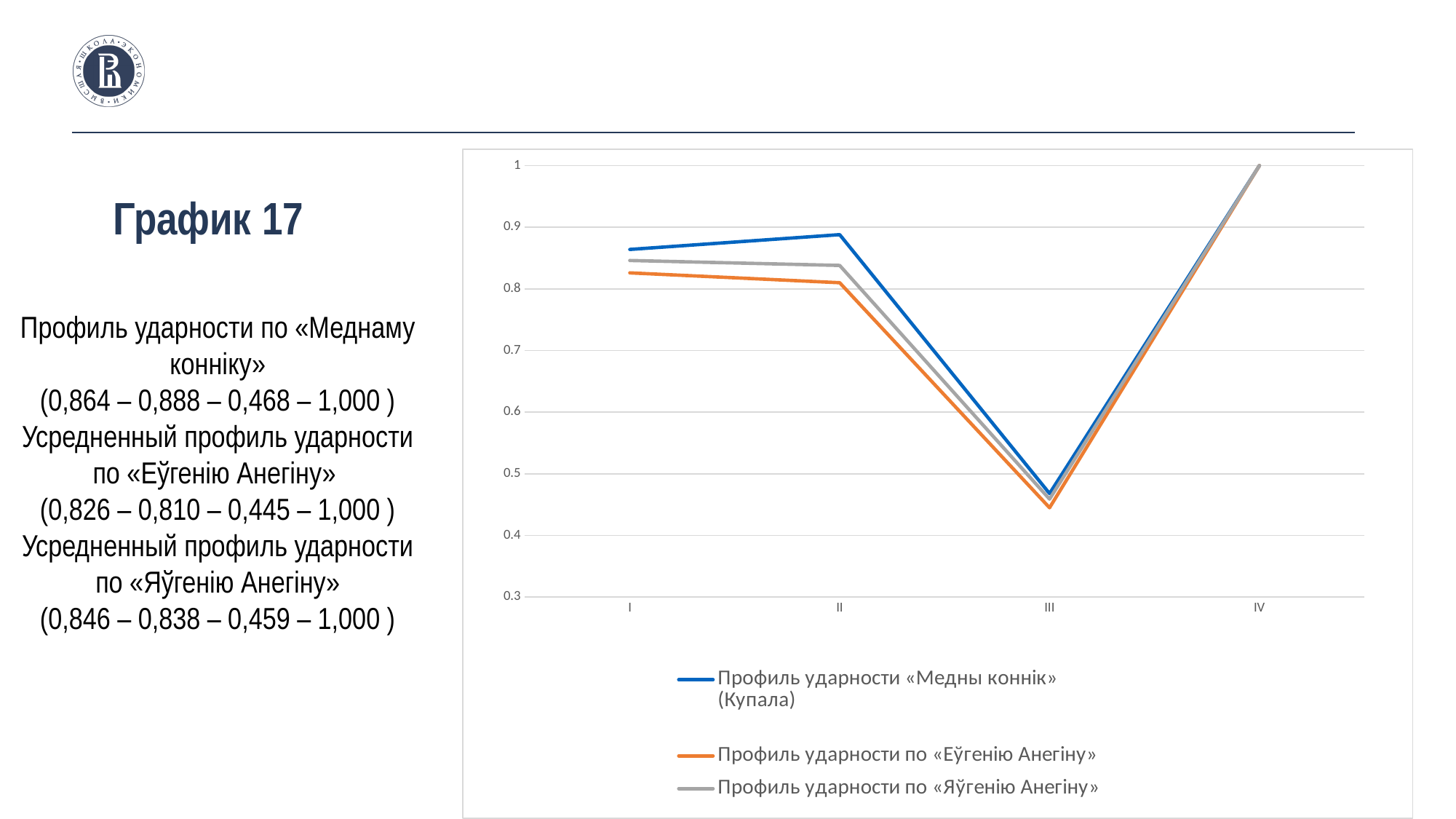
At which position do all three profiles reach their highest value? IV Is the value of the «Еўгенію Анегіну» profile at position III greater or less than 0.5? less How many series does the legend list? 3 Do the values of the lines rise or fall from position II to position III? fall What is the value of the profile по «Еўгенію Анегіну» at position III? 0,445 What kind of chart is shown on the slide? line chart What is the value of the profile по «Яўгенію Анегіну» at position I? 0,846 What is the difference between the «Медны коннік» profile and the «Еўгенію Анегіну» profile at position II? 0,078 How many points are plotted along the x axis for each series? 4 What is the value of the «Медны коннік» (Купала) profile at position II? 0,888 At position I, which is larger: the «Медны коннік» profile or the «Еўгенію Анегіну» profile? «Медны коннік» profile At which position does the «Медны коннік» profile reach its lowest value? III